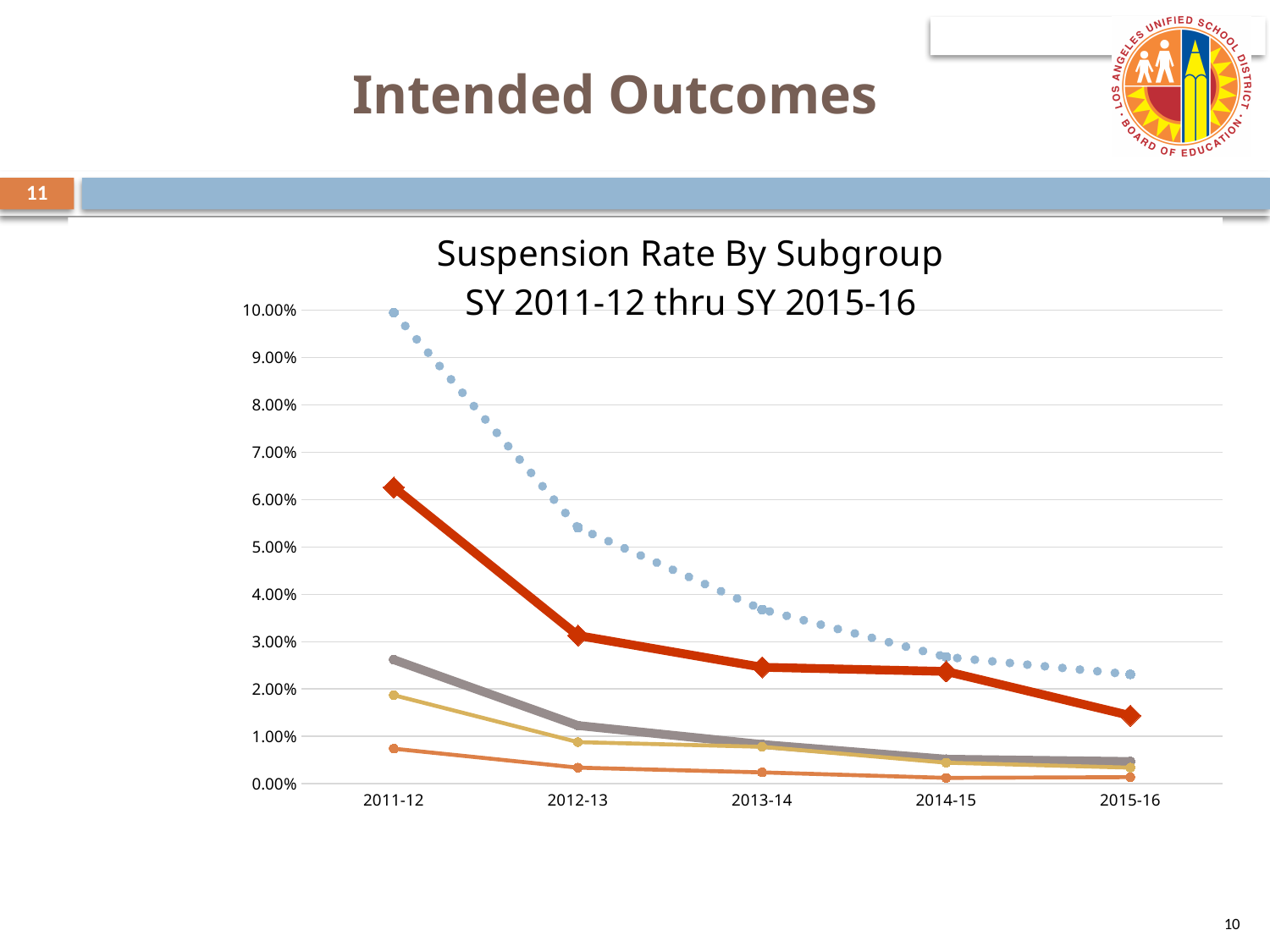
Is the value of the thick red line in 2011-12 greater or less than 5.00%? greater What is the title of the chart? Suspension Rate By Subgroup SY 2011-12 thru SY 2015-16 What is the highest value shown on the y axis? 10.00% What kind of chart is shown on the slide? line chart In 2011-12, which is higher: the dotted blue line or the thick red line? the dotted blue line How many lines are plotted on the chart? 5 Is the value of the dotted blue line in 2015-16 greater or less than 3.00%? less Do the suspension rates rise or fall from 2011-12 to 2015-16? fall Is the value of the dotted blue line in 2011-12 greater or less than 9.00%? greater Which line has the highest values across all years? the dotted blue line How many school years are shown on the x axis? 5